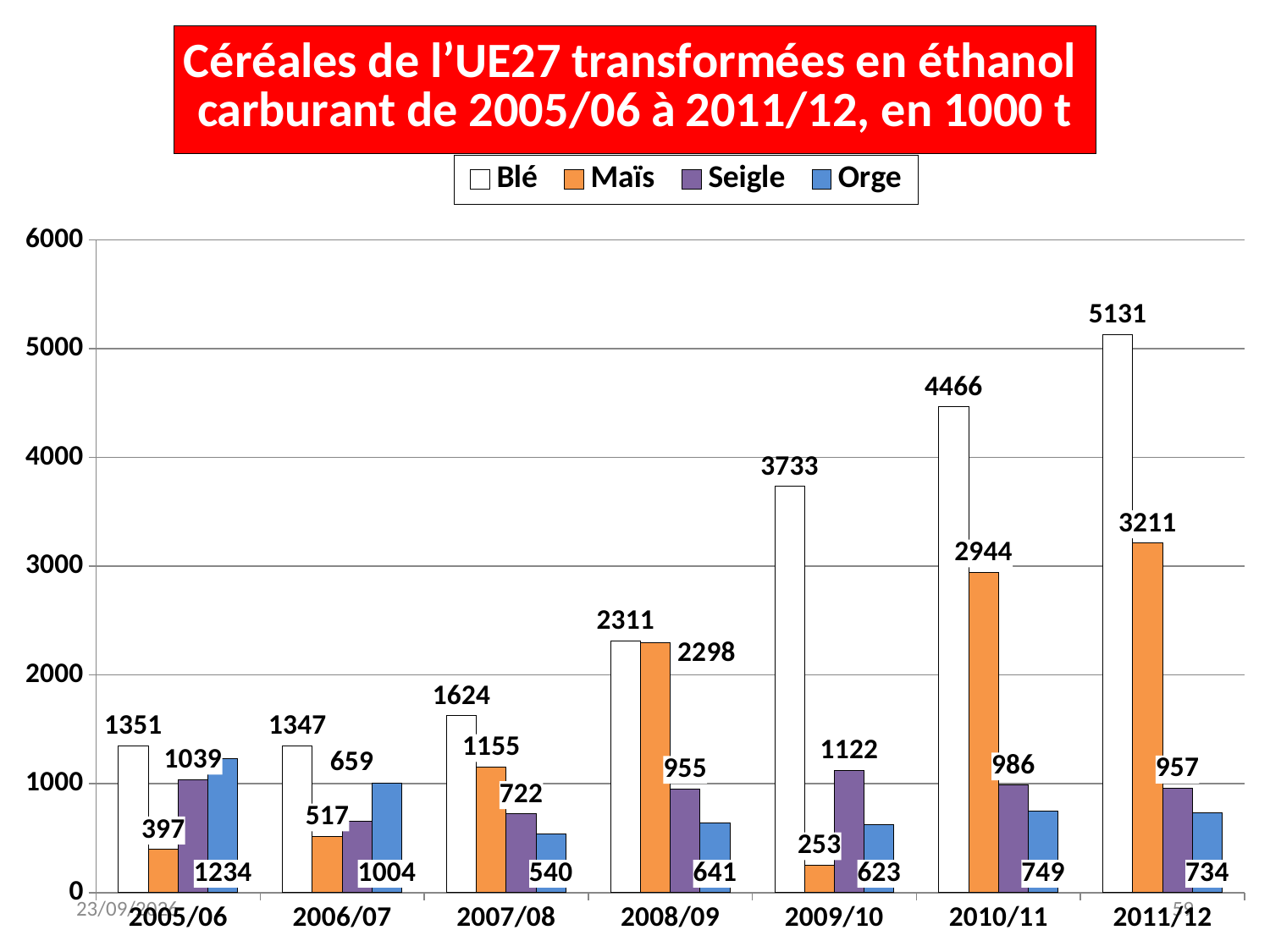
What is the value for Orge in 2005/06? 1234 Which series is shown in orange in the legend? Maïs What is the value for Maïs in 2009/10? 253 What is the value for Blé in 2011/12? 5131 Does the value for Blé rise or fall from 2007/08 to 2011/12? rise What is the difference between Blé and Maïs in 2010/11? 1522 Which is larger in 2005/06, Seigle or Orge? Orge How many seasons (categories) are shown on the x axis? 7 In which season is the value for Blé highest? 2011/12 How many series does the legend list? 4 In which season is the value for Maïs lowest? 2009/10 What type of chart is shown on the slide? bar chart